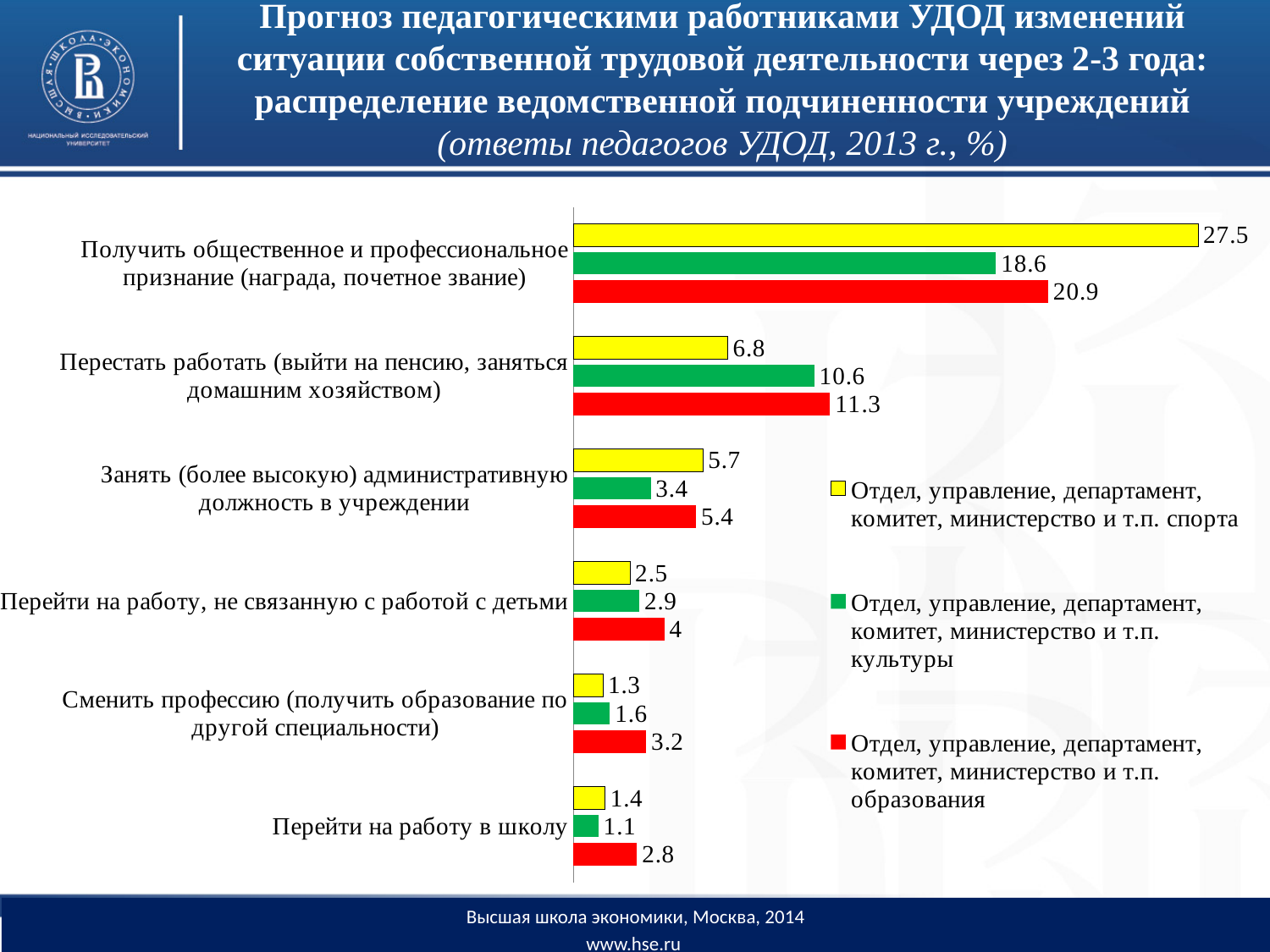
Какое значение для варианта «Перестать работать (выйти на пенсию, заняться домашним хозяйством)» у серии «Отдел, управление, департамент, комитет, министерство и т.п. образования»? 11.3 Какой вариант ответа имеет наибольшее значение у серии «Отдел, управление, департамент, комитет, министерство и т.п. образования»? Получить общественное и профессиональное признание (награда, почетное звание) На сколько значение серии «спорта» больше значения серии «культуры» для варианта «Получить общественное и профессиональное признание (награда, почетное звание)»? 8.9 Сколько вариантов ответа (категорий) показано на диаграмме? 6 Какое значение для варианта «Получить общественное и профессиональное признание (награда, почетное звание)» у серии «Отдел, управление, департамент, комитет, министерство и т.п. спорта»? 27.5 Какое значение для варианта «Перейти на работу в школу» у серии «Отдел, управление, департамент, комитет, министерство и т.п. культуры»? 1.1 Какого типа эта диаграмма? Столбчатая (bar chart) с горизонтальными полосами Каким цветом на диаграмме обозначена серия «Отдел, управление, департамент, комитет, министерство и т.п. образования»? Красным Какая сумма значений трёх серий для варианта «Перейти на работу в школу»? 5.3 Какая серия имеет большее значение для варианта «Перестать работать (выйти на пенсию, заняться домашним хозяйством)»: «спорта» или «культуры»? Отдел, управление, департамент, комитет, министерство и т.п. культуры Какой вариант ответа имеет наименьшее значение у серии «Отдел, управление, департамент, комитет, министерство и т.п. спорта»? Сменить профессию (получить образование по другой специальности) Сколько серий перечислено в легенде диаграммы? 3